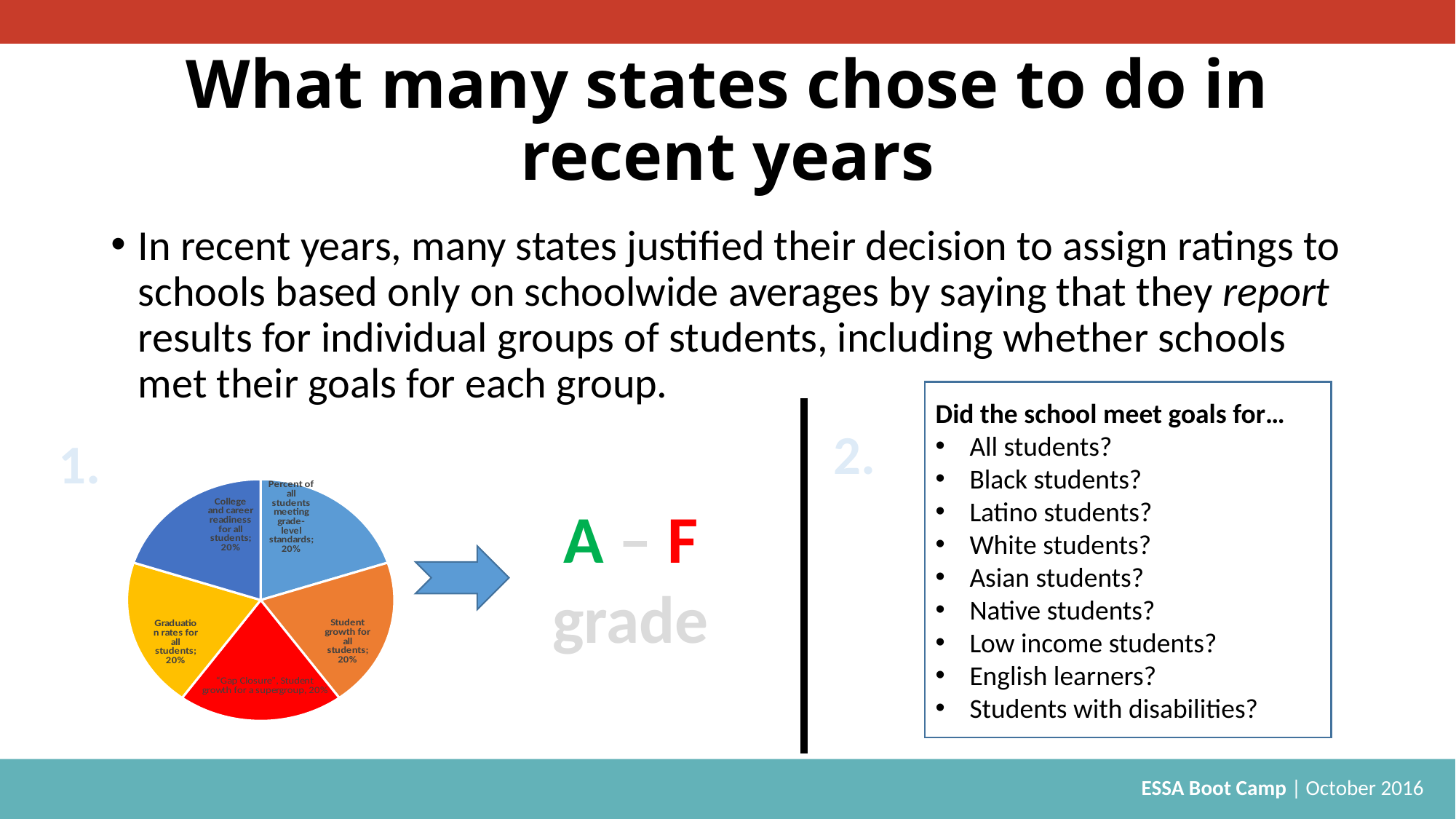
What share of the pie is labelled for 'Percent of all students meeting grade-level standards'? 20% What share of the pie is labelled for '"Gap Closure": Student growth for a supergroup'? 20% What is the difference between the share for 'Graduation rates for all students' and the share for 'Student growth for all students'? 0% How many slices does the pie chart have? 5 What is the combined share of the 'Graduation rates for all students' and 'College and career readiness for all students' slices? 40% What share of the pie is labelled for 'Student growth for all students'? 20% What share of the pie is labelled for 'Graduation rates for all students'? 20% What share of the pie is labelled for 'College and career readiness for all students'? 20% Do all slices of the pie chart have the same share? Yes What colour is the '"Gap Closure": Student growth for a supergroup' slice? red What kind of chart is shown on the slide? pie chart